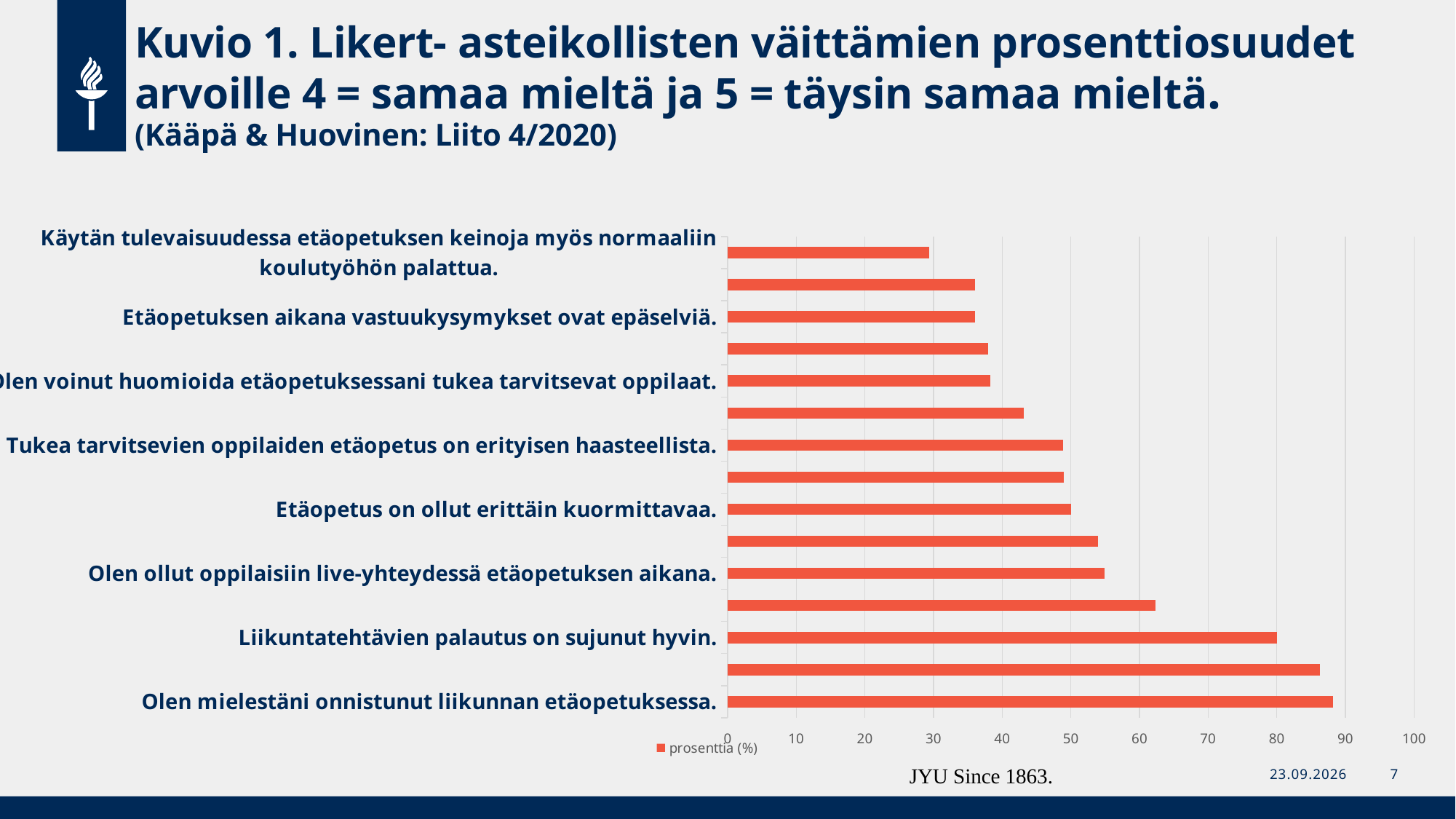
Is the value for "Olen mielestäni onnistunut liikunnan etäopetuksessa." greater or less than 80? greater Is the value for "Liikuntatehtävien palautus on sujunut hyvin." greater or less than 70? greater Which has the larger value: "Liikuntatehtävien palautus on sujunut hyvin." or "Etäopetus on ollut erittäin kuormittavaa."? Liikuntatehtävien palautus on sujunut hyvin. Which has the larger value: "Olen ollut oppilaisiin live-yhteydessä etäopetuksen aikana." or "Etäopetuksen aikana vastuukysymykset ovat epäselviä."? Olen ollut oppilaisiin live-yhteydessä etäopetuksen aikana. How many series does the legend list? 1 What is the legend entry for the series in the chart? prosenttia (%) Which labelled statement has the highest value in the chart? Olen mielestäni onnistunut liikunnan etäopetuksessa. What kind of chart is shown on the slide? bar chart Is the value for "Etäopetus on ollut erittäin kuormittavaa." greater or less than 60? less How many bars are plotted in the chart? 15 Which labelled statement has the lowest value in the chart? Käytän tulevaisuudessa etäopetuksen keinoja myös normaaliin koulutyöhön palattua.